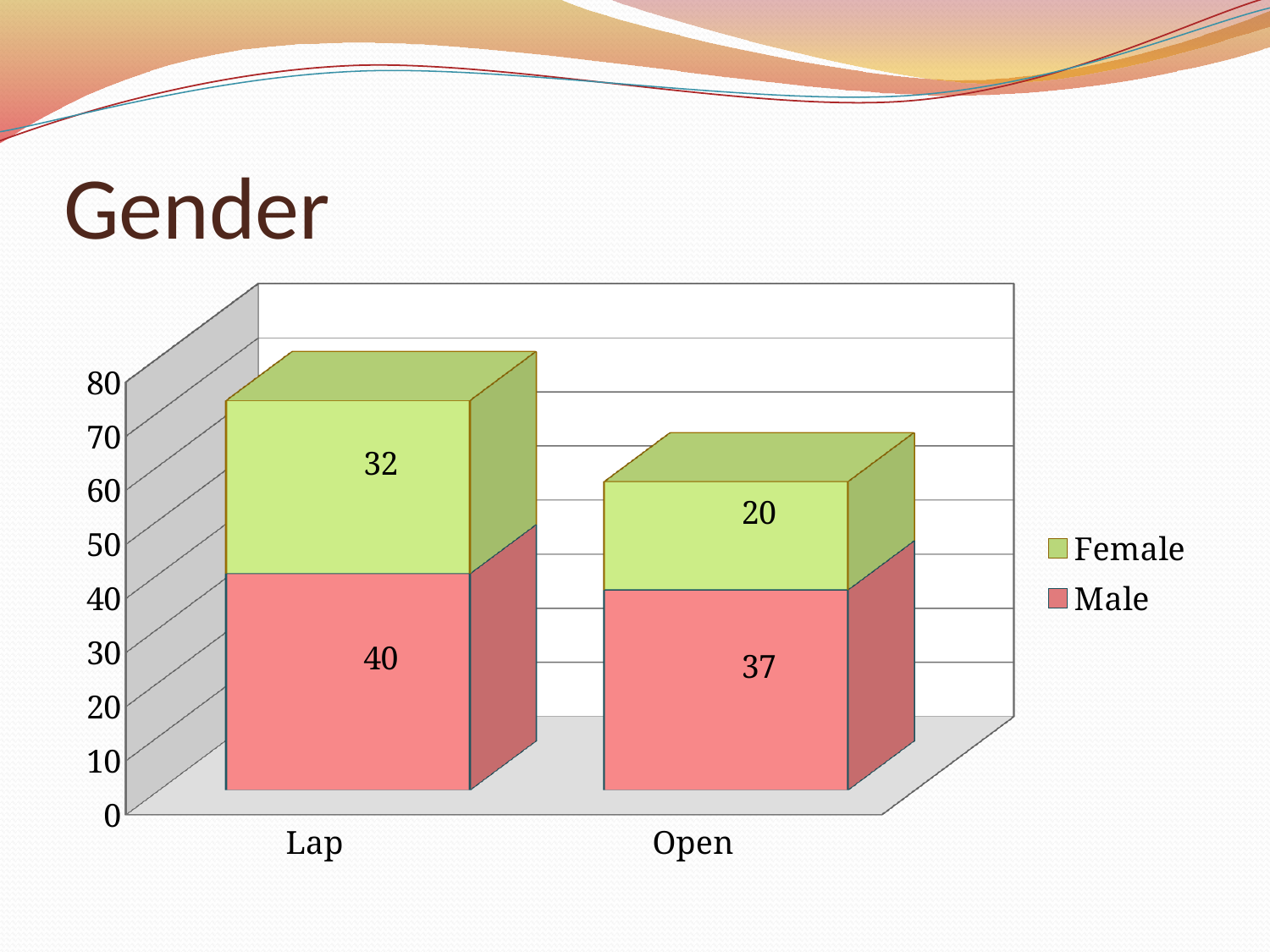
How many series does the legend list? 2 What kind of chart is shown on the slide? Stacked bar chart How many categories are shown on the x axis? 2 What is the Female value for Lap? 32 What is the total of the stacked bar for Open? 57 What is the Male value for Lap? 40 What is the Female value for Open? 20 What is the total of the stacked bar for Lap? 72 What is the difference between the Female values for Lap and Open? 12 What is the Male value for Open? 37 Which category has the higher Female value, Lap or Open? Lap Which category has the lowest Male value? Open